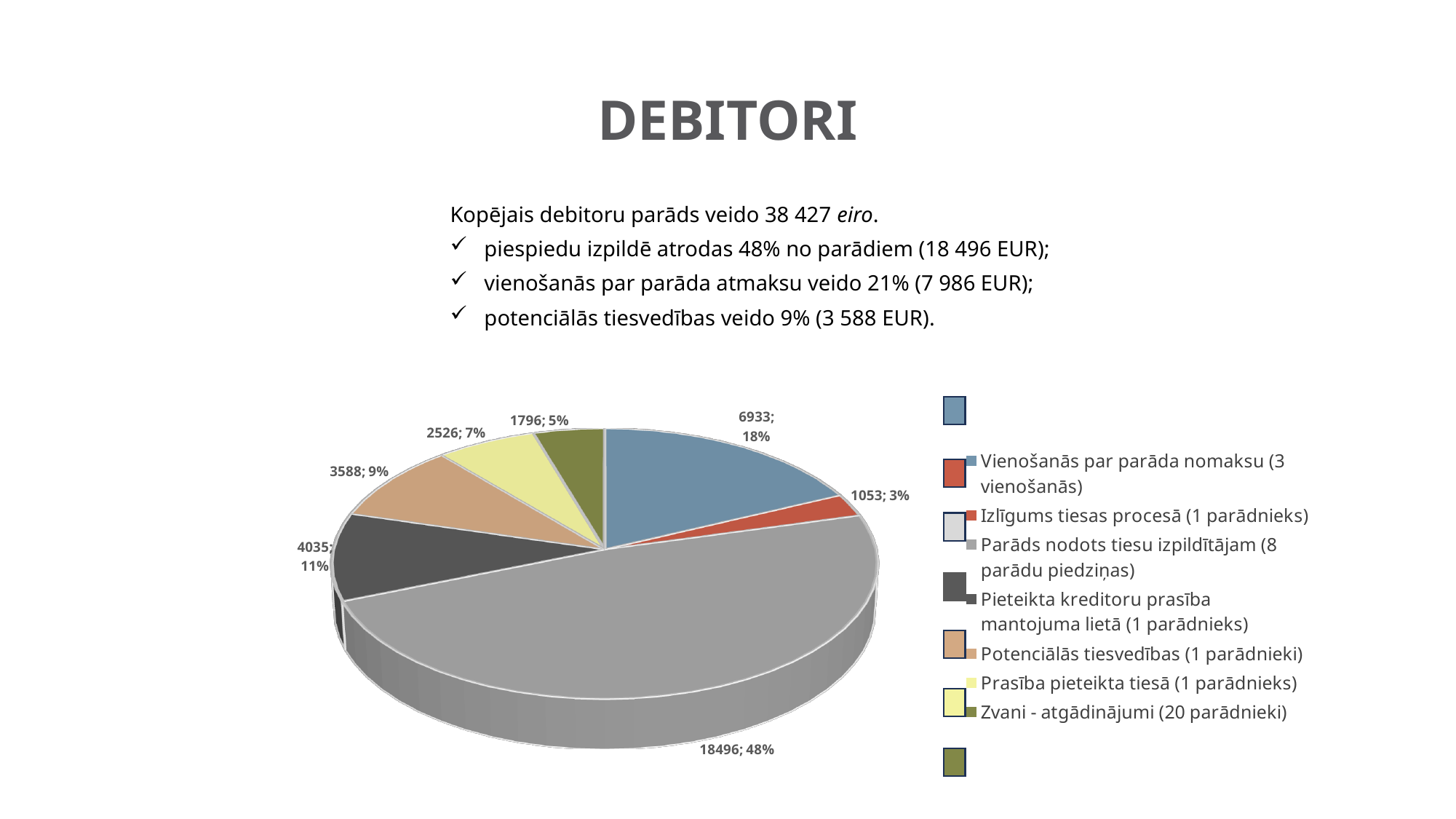
What value is shown for the slice 'Parāds nodots tiesu izpildītājam (8 parādu piedziņas)'? 18496 Which slice of the pie chart is the largest? Parāds nodots tiesu izpildītājam (8 parādu piedziņas) What is the title of the slide containing the pie chart? DEBITORI How many slices does the pie chart have? 7 Which slice of the pie chart is the smallest? Izlīgums tiesas procesā (1 parādnieks) What is the difference between the values for 'Pieteikta kreditoru prasība mantojuma lietā (1 parādnieks)' and 'Potenciālās tiesvedības (1 parādnieki)'? 447 What share of the pie does 'Parāds nodots tiesu izpildītājam (8 parādu piedziņas)' represent? 48% How many entries does the legend of the pie chart list? 7 What kind of chart is shown on the slide? pie chart What share of the pie does 'Potenciālās tiesvedības (1 parādnieki)' represent? 9% Which is larger: the value for 'Prasība pieteikta tiesā (1 parādnieks)' or the value for 'Zvani - atgādinājumi (20 parādnieki)'? Prasība pieteikta tiesā (1 parādnieks) What value is shown for the slice 'Vienošanās par parāda nomaksu (3 vienošanās)'? 6933